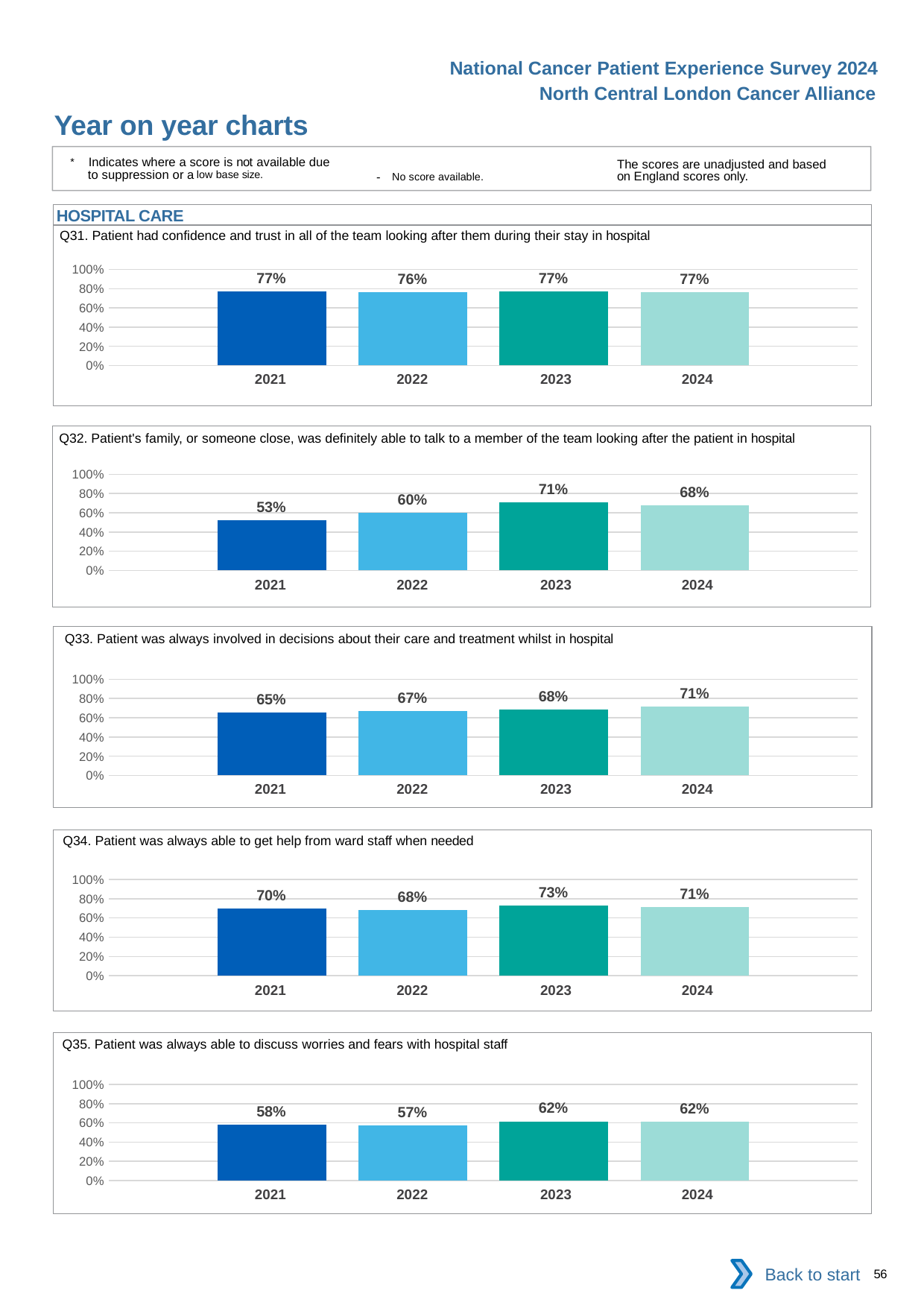
What type of chart is used for Q34 (patient was always able to get help from ward staff)? bar chart In the Q32 chart (patient's family was definitely able to talk to a member of the team), which year has the highest value? 2023 In the Q33 chart (patient was always involved in decisions about their care), do the values rise or fall from 2021 to 2024? rise In the Q32 chart (patient's family was definitely able to talk to a member of the team), what is the difference between the 2023 and 2021 values? 18 percentage points In the Q35 chart (patient was always able to discuss worries and fears), what is the difference between the 2023 and 2022 values? 5 percentage points In the Q31 chart (patient had confidence and trust in all of the team), what is the value for 2022? 76% In the Q35 chart (patient was always able to discuss worries and fears), what is the value for 2021? 58% How many years are shown on the x axis of the Q31 chart? 4 In the Q34 chart (patient was always able to get help from ward staff), which is larger, the 2021 value or the 2022 value? 2021 In the Q33 chart (patient was always involved in decisions about their care), what is the value for 2024? 71% In the Q32 chart (patient's family was definitely able to talk to a member of the team), which year has the lowest value? 2021 In the Q34 chart (patient was always able to get help from ward staff), which year has the highest value? 2023